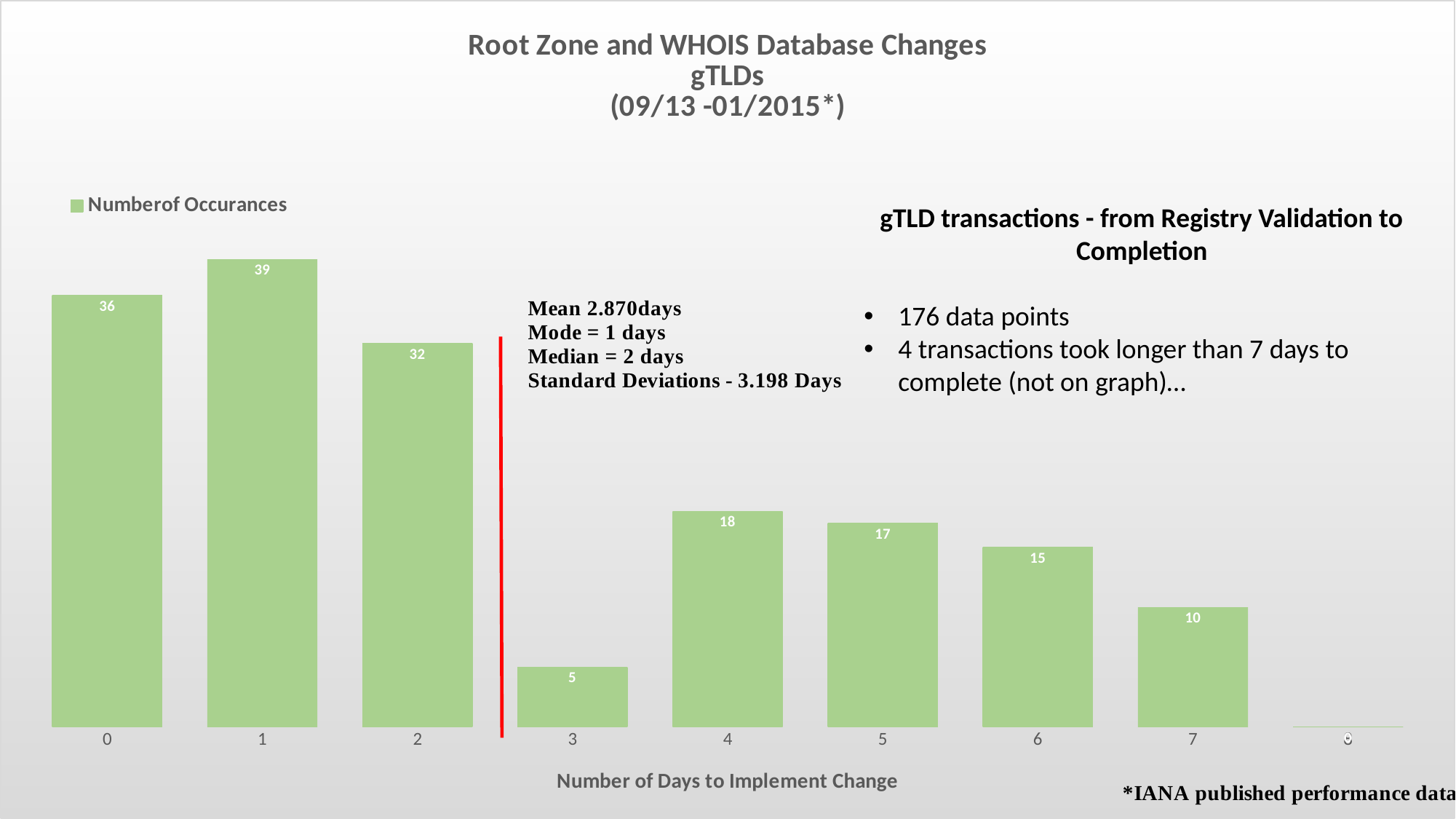
What kind of chart is shown on the slide? Bar chart Which number of days to implement change has the highest number of occurrences? 1 What is the number of occurrences for 3 days to implement change? 5 What is the number of occurrences for 1 day to implement change? 39 Which has more occurrences, 5 days or 6 days? 5 days What is the difference in occurrences between 4 days and 3 days? 13 What is the x-axis title of the chart? Number of Days to Implement Change How many series does the legend list? 1 What is the difference in occurrences between 1 day and 2 days? 7 What is the number of occurrences for 0 days to implement change? 36 Among the days 0 through 7, which number of days has the lowest number of occurrences? 3 What is the number of occurrences for 7 days to implement change? 10